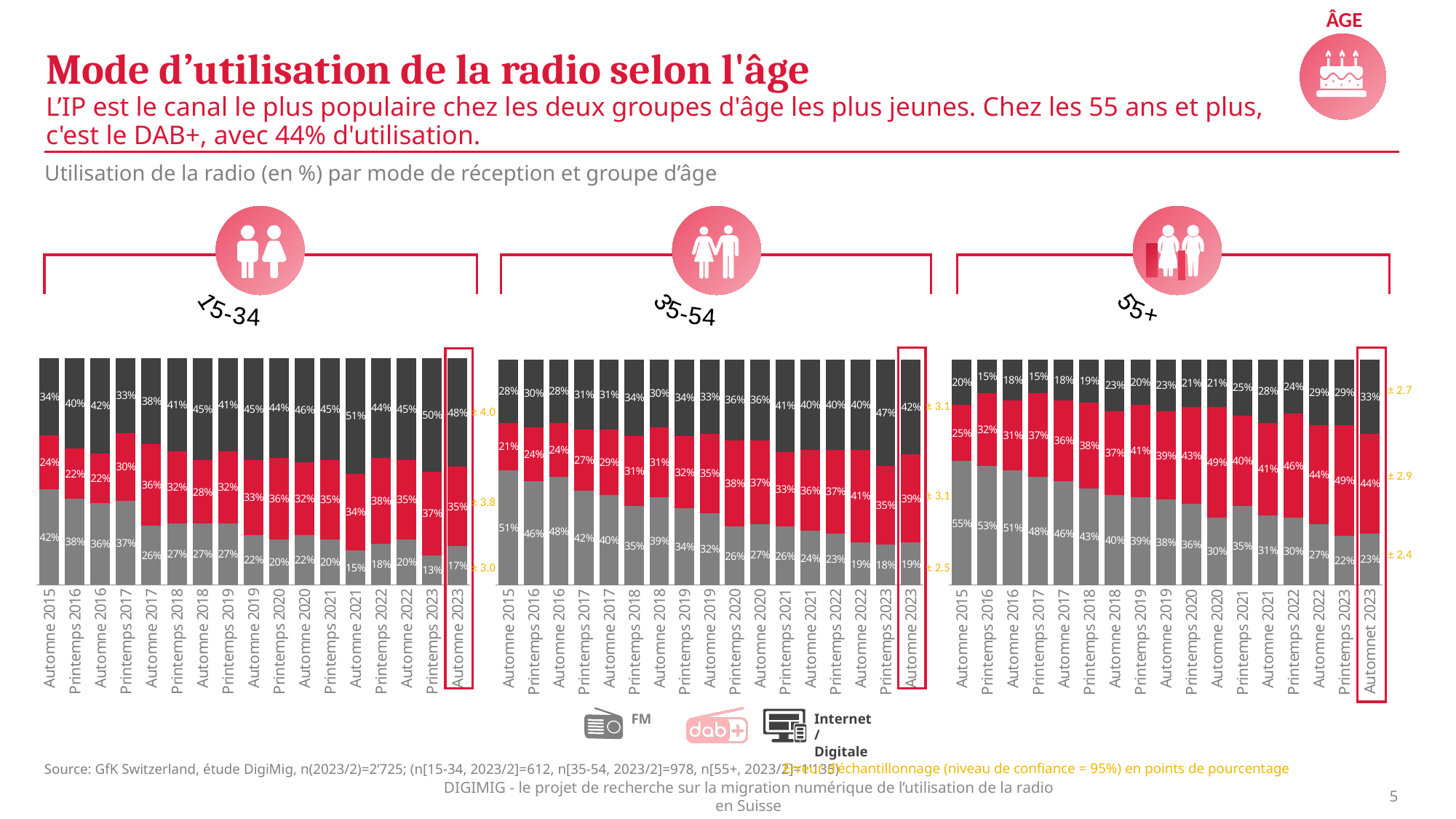
Which series is shown in red in the charts? DAB+ In the 35-54 chart, what is the Internet/Digitale value for Printemps 2023? 47% In the 55+ chart, what is the DAB+ value for Automnet 2023? 44% In the 55+ chart, which period has the highest FM value? Automne 2015 In the 15-34 chart, which period has the lowest FM value? Printemps 2023 In the 35-54 chart, what is the difference between the FM value for Automne 2015 and the FM value for Automne 2023? 32 percentage points In the 15-34 chart, what is the FM value for Automne 2023? 17% What kind of chart is used for the 35-54 age group? Stacked bar chart In the 55+ chart, which is larger for Automnet 2023: the FM value or the Internet/Digitale value? Internet/Digitale How many series does the legend list? 3 How many periods are shown on the x axis of the 15-34 chart? 17 In the 55+ chart, does the FM value rise or fall from Automne 2015 to Automnet 2023? Fall